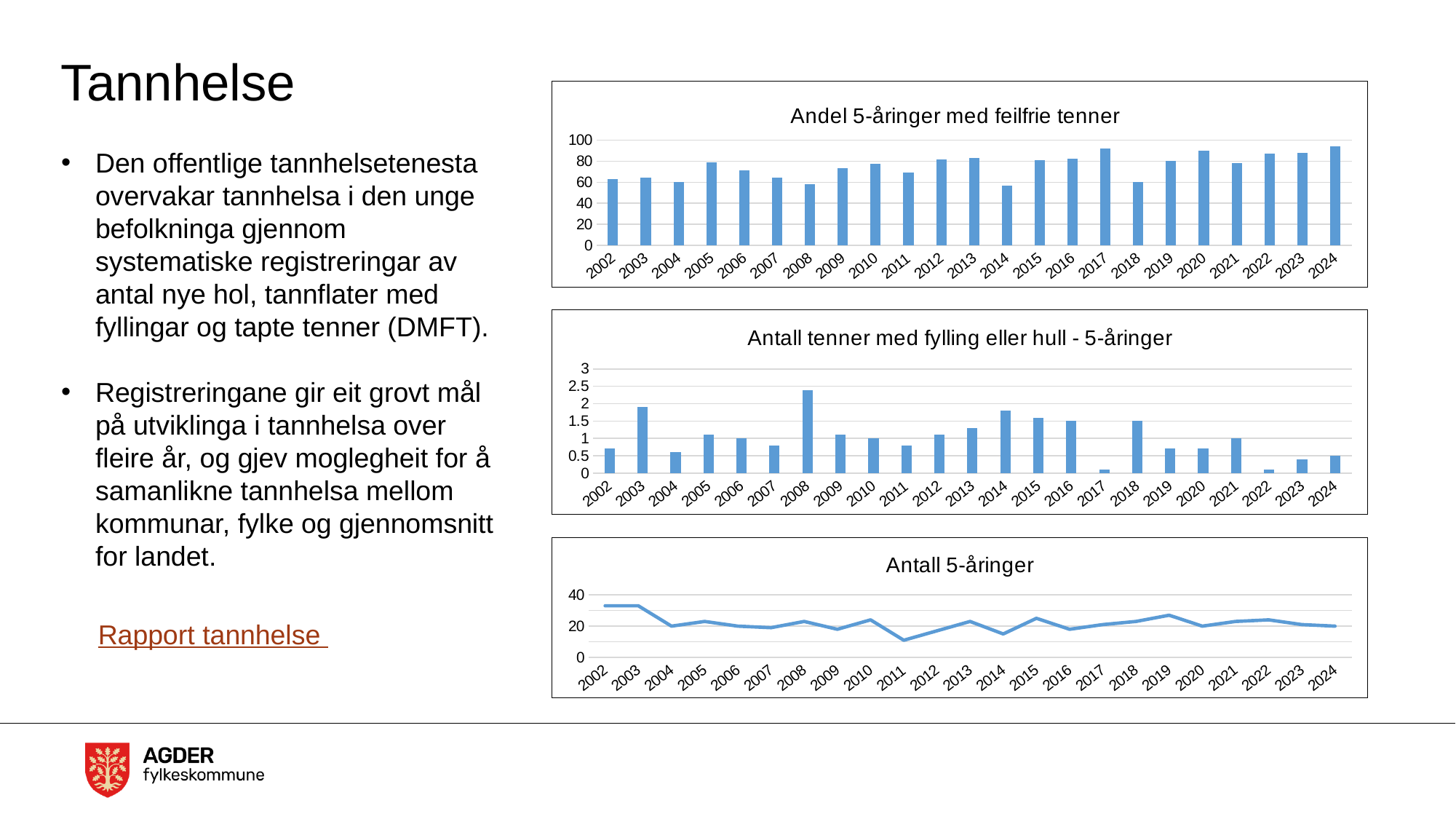
In the chart 'Andel 5-åringer med feilfrie tenner', do the values generally rise or fall from 2002 to 2024? rise In the chart 'Antall 5-åringer', is the value for 2002 greater or less than 20? greater In the chart 'Andel 5-åringer med feilfrie tenner', is the value for 2002 greater or less than 80? less In the chart 'Andel 5-åringer med feilfrie tenner', is the value for 2017 greater or less than 80? greater In the chart 'Antall tenner med fylling eller hull - 5-åringer', do the values generally rise or fall from 2002 to 2024? fall In the chart 'Antall tenner med fylling eller hull - 5-åringer', which year has the highest value? 2008 In the chart 'Antall 5-åringer', which year has the lowest value? 2011 What type of chart is 'Andel 5-åringer med feilfrie tenner'? bar chart What type of chart is 'Antall 5-åringer'? line chart In the chart 'Andel 5-åringer med feilfrie tenner', how many years are shown on the x axis? 23